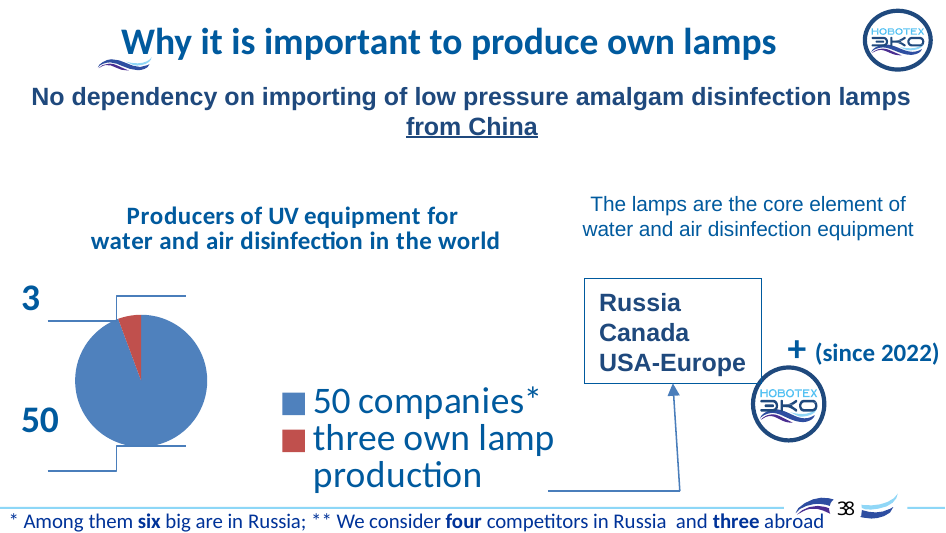
What value is shown for the '50 companies' slice of the pie chart? 50 How many entries does the legend of the pie chart list? 2 What colour is the 'three own lamp production' slice in the pie chart? red What value is shown for the 'three own lamp production' slice of the pie chart? 3 Which slice of the pie chart is the smallest? three own lamp production Which is larger in the pie chart: '50 companies' or 'three own lamp production'? 50 companies What is the difference between the '50 companies' value and the 'three own lamp production' value in the pie chart? 47 How many slices does the pie chart have? 2 What type of chart is shown on the slide? pie chart What is the title of the pie chart? Producers of UV equipment for water and air disinfection in the world Which slice of the pie chart is the largest? 50 companies What is the total of the two values shown in the pie chart? 53